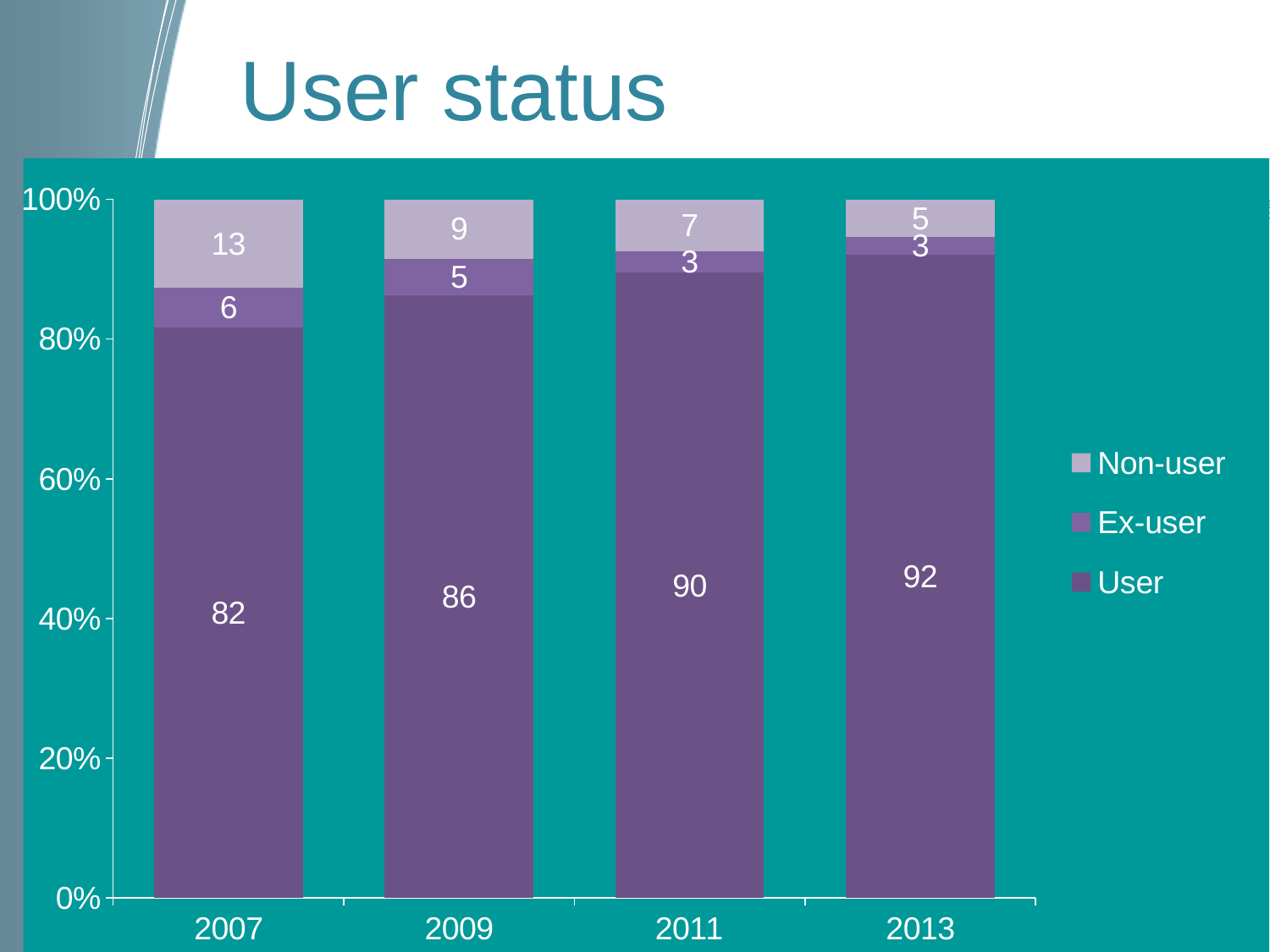
What is the value for Non-user in 2009? 9 Does the User value rise or fall from 2007 to 2013? Rise How many years are shown on the x axis? 4 What is the difference between the User values for 2013 and 2007? 10 What is the value for Ex-user in 2013? 3 What is the value for User in 2007? 82 What kind of chart is shown? Stacked bar chart What is the title of the chart? User status Which year has the highest value for User? 2013 Which is larger, the Non-user value in 2007 or in 2011? 2007 Which year has the lowest value for Non-user? 2013 How many series does the legend list? 3